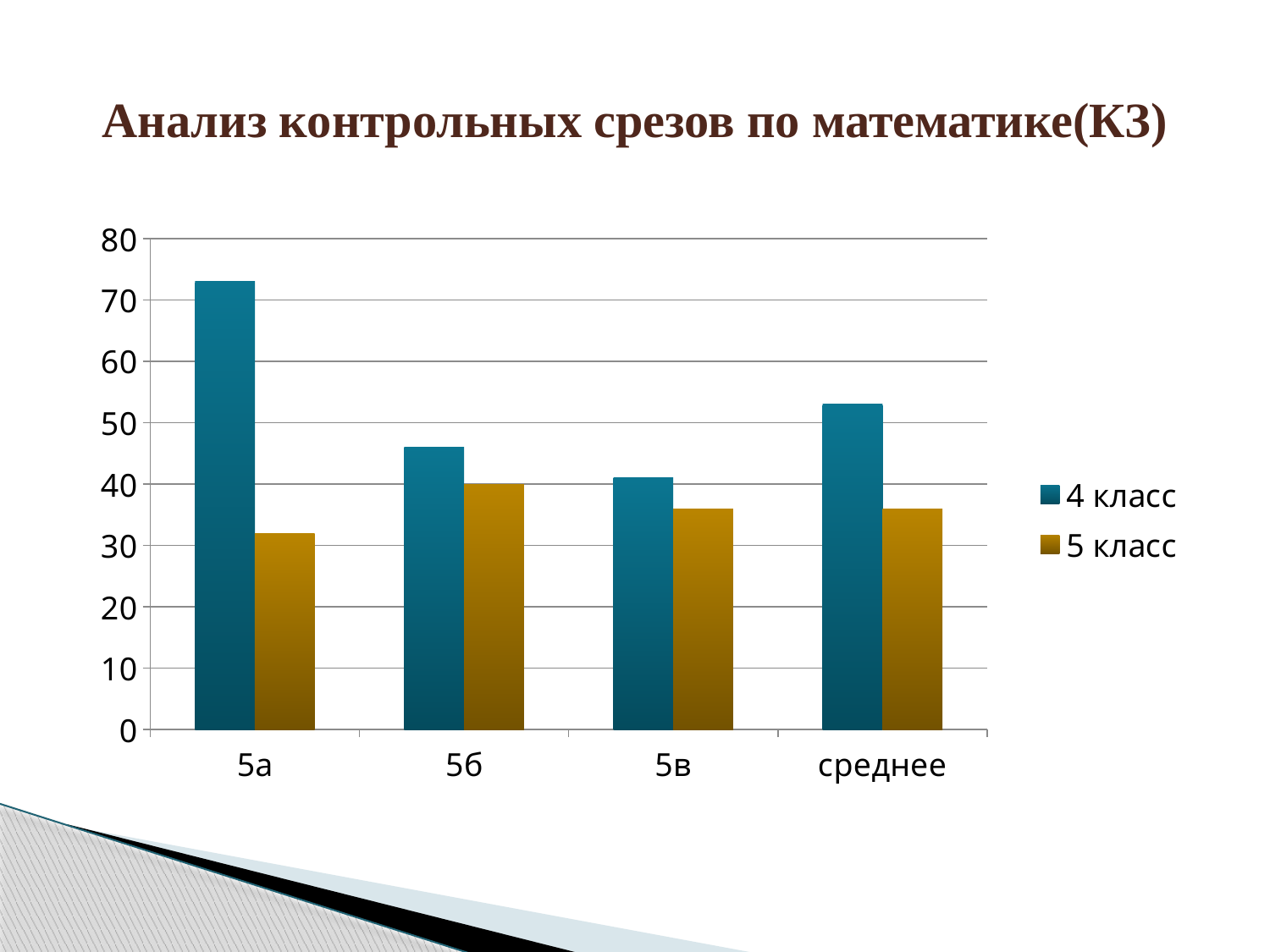
Which category has the lowest value for the 5 класс series? 5а Is the value for 4 класс at 5а greater or less than 60? greater For 5а, which series has the larger value, 4 класс or 5 класс? 4 класс Which category has the highest value for the 4 класс series? 5а Which category has the highest value for the 5 класс series? 5б Which category has the lowest value for the 4 класс series? 5в What is the title of the slide? Анализ контрольных срезов по математике(КЗ) Is the value for 5 класс at 5а greater or less than 40? less How many categories are shown on the x axis? 4 How many series does the legend list? 2 What kind of chart is shown on the slide? bar chart Is the value for 4 класс at среднее greater or less than 50? greater